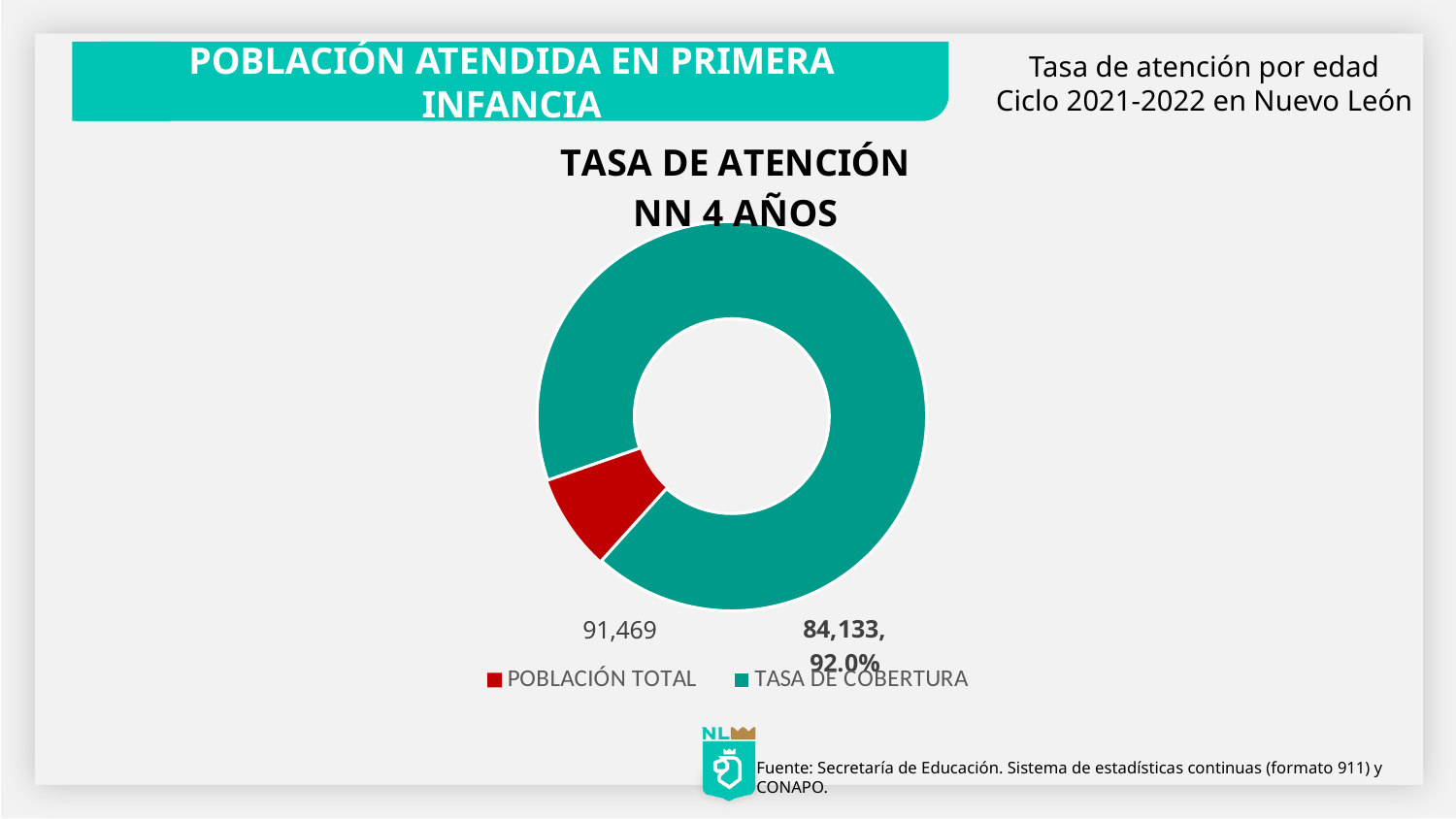
What is the title of the chart? TASA DE ATENCIÓN NN 4 AÑOS What is the difference between the POBLACIÓN TOTAL value and the TASA DE COBERTURA value? 7,336 Which colour represents TASA DE COBERTURA in the chart? Teal What percentage is printed for the TASA DE COBERTURA slice? 92.0% What value is shown for POBLACIÓN TOTAL? 91,469 How many slices does the doughnut chart have? 2 Which legend entry is represented by the red slice? POBLACIÓN TOTAL How many entries does the chart legend list? 2 What value is shown for TASA DE COBERTURA? 84,133 What type of chart is shown on the slide? Doughnut chart